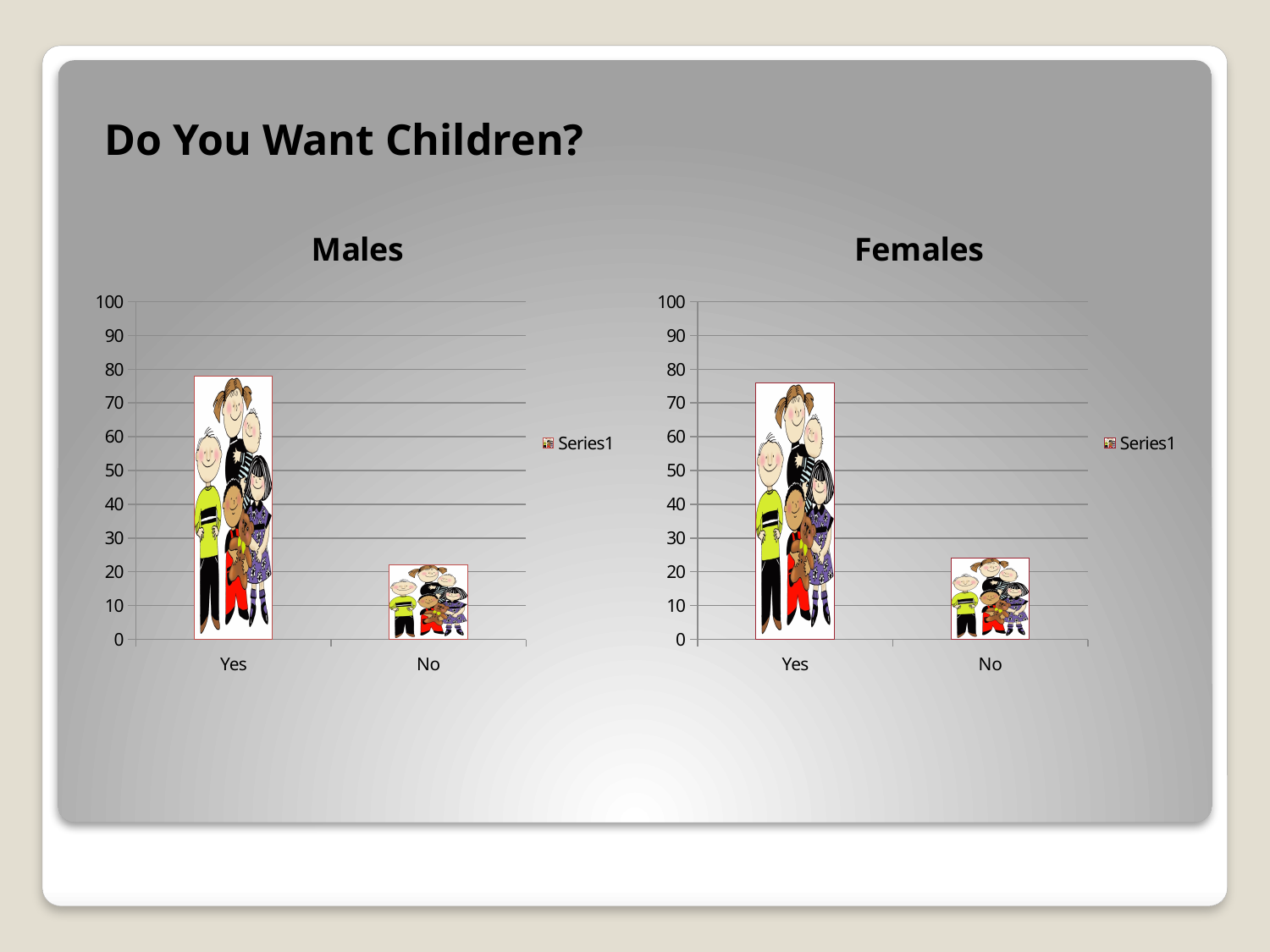
In the Males chart, is the value for No greater or less than 30? less In the Males chart, which category has the lowest value? No In the Males chart, which category has the highest value? Yes In the Females chart, is the value for Yes greater or less than 70? greater How many categories are shown on the x axis of the Males chart? 2 In the Females chart, which category has the highest value? Yes In the Females chart, is the value for No greater or less than 30? less What kind of chart is the Males chart? bar chart How many series does the legend of the Females chart list? 1 In the Females chart, which category has the lowest value? No In the Females chart, which is larger, the value for Yes or the value for No? Yes